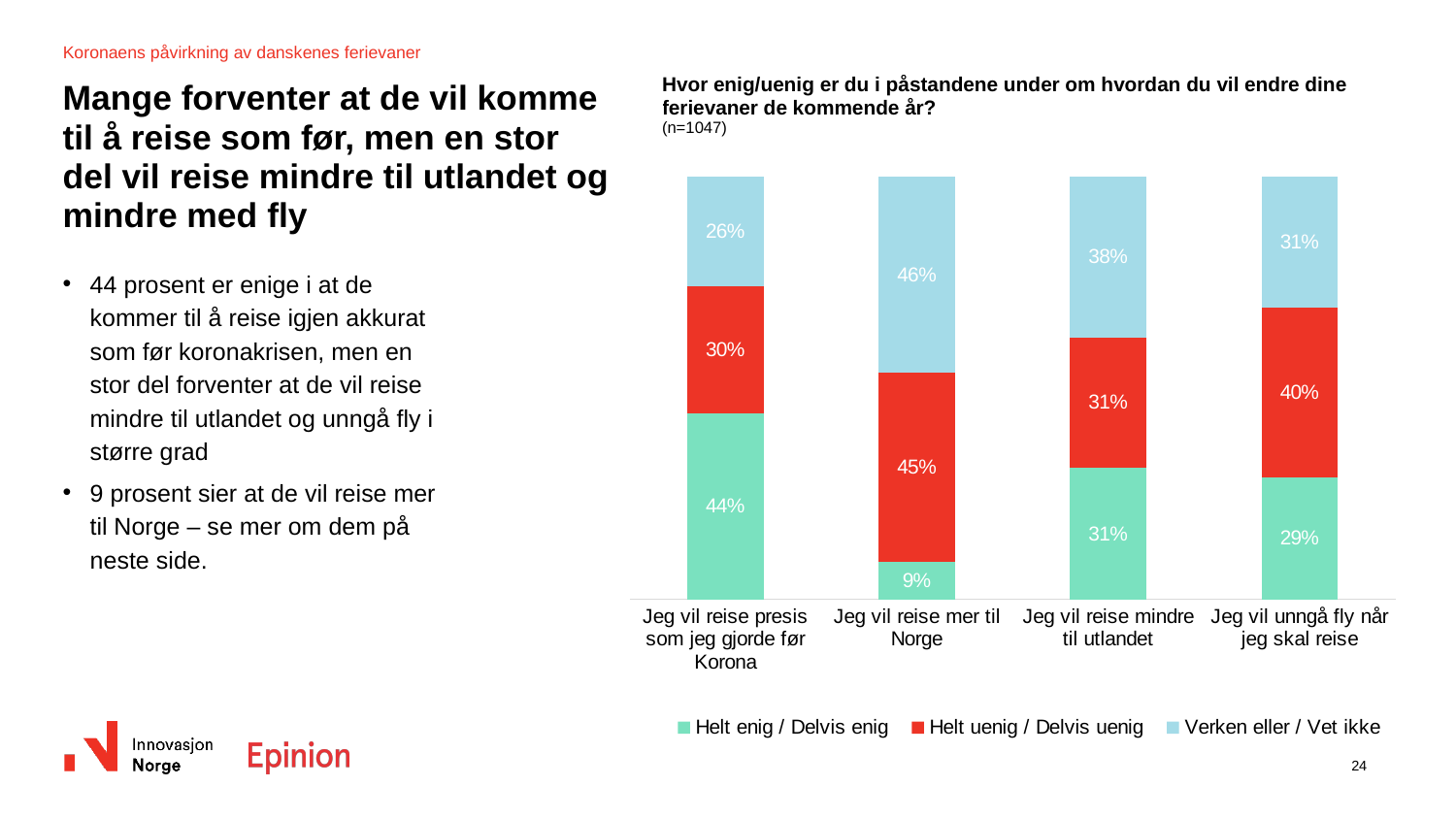
Which statement has the lowest 'Helt enig / Delvis enig' share? Jeg vil reise mer til Norge What is the 'Verken eller / Vet ikke' value for 'Jeg vil reise mindre til utlandet'? 38% What is the 'Helt uenig / Delvis uenig' value for 'Jeg vil unngå fly når jeg skal reise'? 40% How many statements (categories) are shown on the x axis of the chart? 4 What is the 'Helt uenig / Delvis uenig' value for 'Jeg vil reise mer til Norge'? 45% Which statement has the highest 'Verken eller / Vet ikke' share? Jeg vil reise mer til Norge What type of chart is shown on the slide? Stacked bar chart What is the difference between the 'Helt enig / Delvis enig' shares for 'Jeg vil reise presis som jeg gjorde før Korona' and 'Jeg vil reise mer til Norge'? 35 percentage points How many series does the chart legend list? 3 Which is larger for 'Jeg vil unngå fly når jeg skal reise': the 'Helt enig / Delvis enig' share or the 'Helt uenig / Delvis uenig' share? Helt uenig / Delvis uenig What is the sample size (n) stated under the chart title? n=1047 What share of respondents are 'Helt enig / Delvis enig' with 'Jeg vil reise presis som jeg gjorde før Korona'? 44%